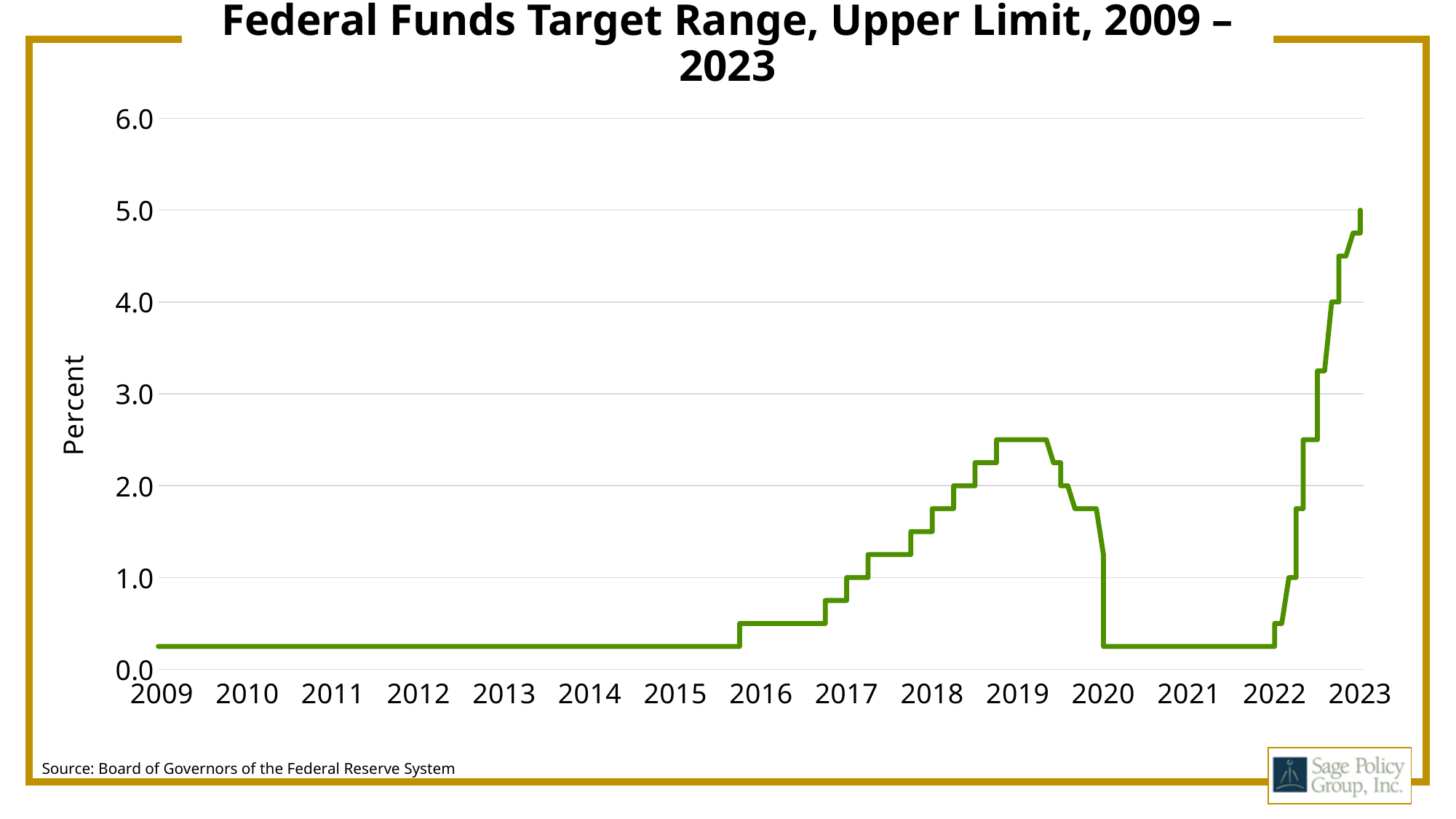
What is the label on the vertical axis of the chart? Percent Is the value at the start of 2019 greater or less than 2.0? greater What kind of chart is shown on the slide? line chart Is the value at the end of 2022 greater or less than 4.0? greater Does the line rise or fall between mid-2019 and 2020? fall Does the line rise or fall between 2016 and the start of 2019? rise Is the value for 2013 greater or less than 1.0? less In which year does the line reach its highest point? 2023 Which is larger, the value at the start of 2023 or the value at the start of 2019? 2023 What is the title of the chart? Federal Funds Target Range, Upper Limit, 2009 – 2023 How many year labels are shown on the x axis? 15